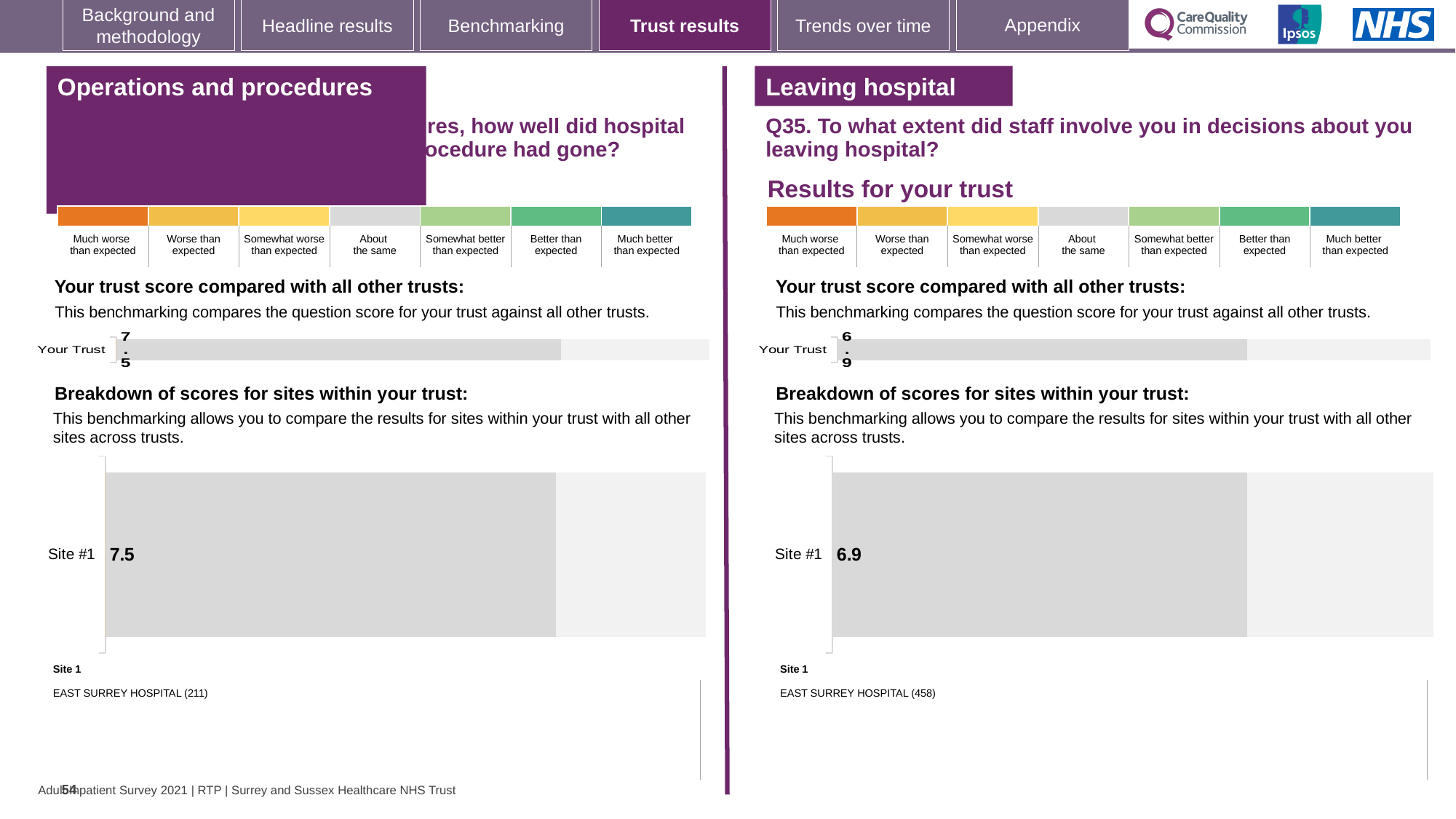
What type of chart is used to show the Site #1 score in the Leaving hospital section? Bar chart In the Operations and procedures section, what is the score shown for Your Trust in the 'Your trust score compared with all other trusts' chart? 7.5 In the Operations and procedures section, what score is shown for Site #1 in the 'Breakdown of scores for sites within your trust' chart? 7.5 What type of chart is used to show the Your Trust score in the Operations and procedures section? Bar chart What is the difference between the Site #1 score in the Operations and procedures section and the Site #1 score in the Leaving hospital section? 0.6 In the Operations and procedures section, which hospital is listed as Site 1 below the breakdown chart? EAST SURREY HOSPITAL (211) In the Leaving hospital section, which hospital is listed as Site 1 below the breakdown chart? EAST SURREY HOSPITAL (458) How many sites are shown in the 'Breakdown of scores for sites within your trust' chart in the Operations and procedures section? 1 How many sites are shown in the 'Breakdown of scores for sites within your trust' chart in the Leaving hospital section? 1 In the Leaving hospital section, what score is shown for Site #1 in the 'Breakdown of scores for sites within your trust' chart? 6.9 Which is larger: the Your Trust score in the Operations and procedures section or the Your Trust score in the Leaving hospital section? Operations and procedures In the Leaving hospital section, what is the score shown for Your Trust in the 'Your trust score compared with all other trusts' chart? 6.9